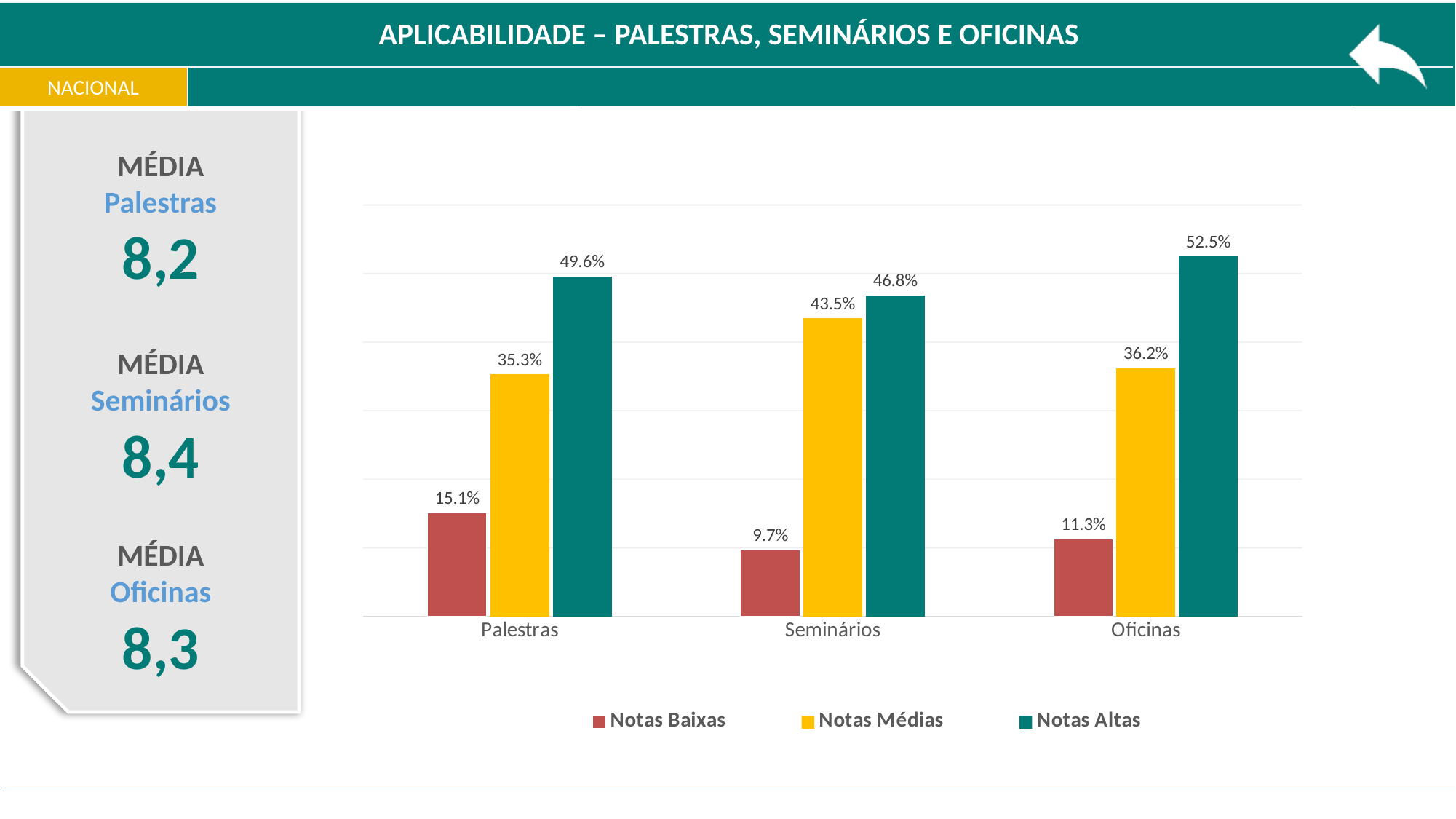
How many series does the chart legend list? 3 What kind of chart is shown on the slide? Bar chart Which category has the highest value for Notas Médias? Seminários Which category has the lowest value for Notas Baixas? Seminários What is the difference between Notas Baixas for Palestras and Notas Baixas for Seminários? 5.4 percentage points What is the value for Notas Baixas in the Seminários category? 9.7% What is the value for Notas Médias in the Palestras category? 35.3% What is the difference between Notas Médias for Seminários and Notas Médias for Palestras? 8.2 percentage points What is the value for Notas Altas in the Oficinas category? 52.5% Which is larger: Notas Altas for Palestras or Notas Altas for Seminários? Notas Altas for Palestras How many categories are shown on the x axis of the chart? 3 Which category has the highest value for Notas Altas? Oficinas